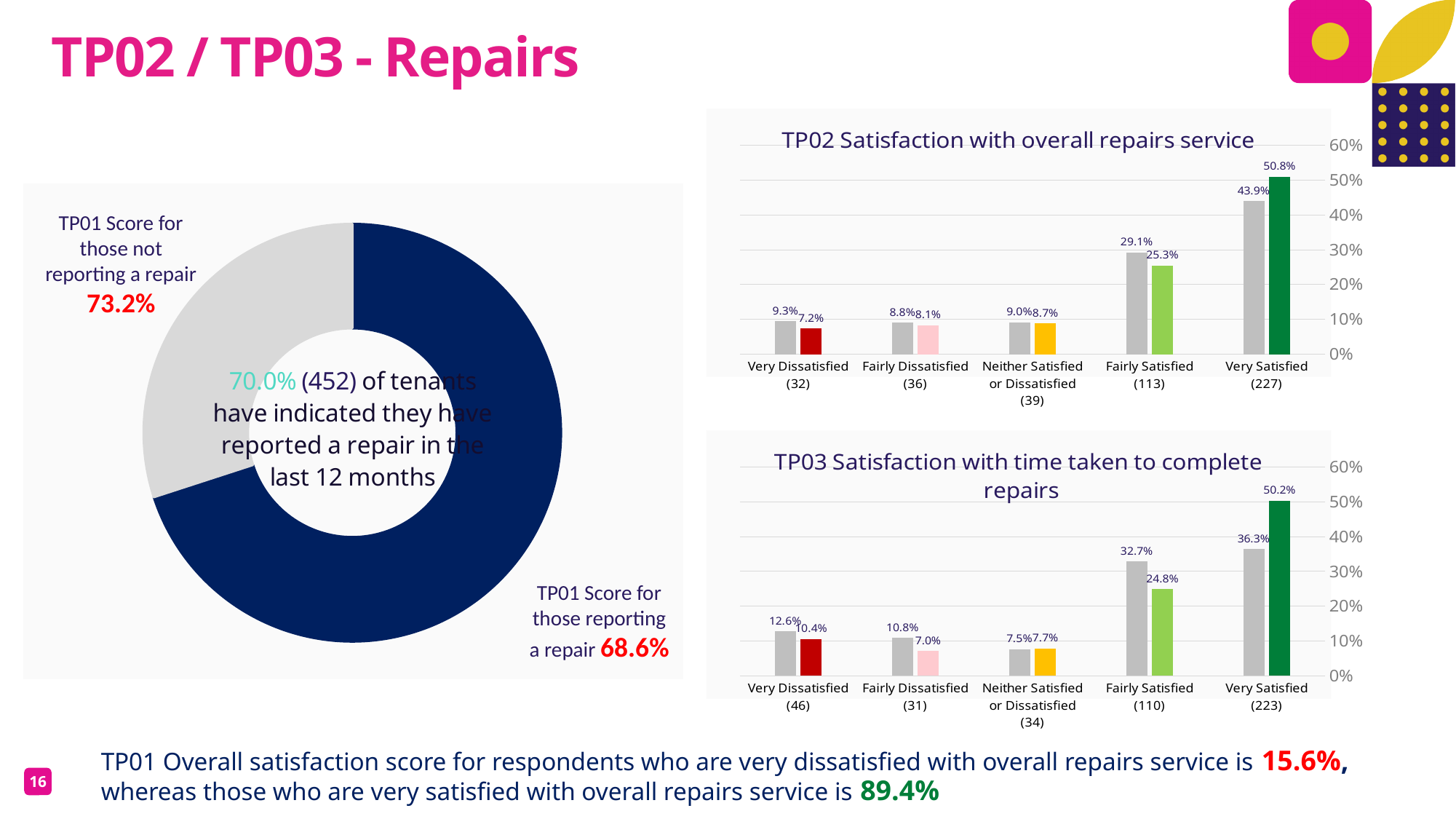
In the TP02 Satisfaction with overall repairs service chart, what is the difference between the green bar (50.8%) and the grey bar (43.9%) for Very Satisfied? 6.9% In the TP03 Satisfaction with time taken to complete repairs chart, which category has the lowest grey bar? Neither Satisfied or Dissatisfied In the TP02 Satisfaction with overall repairs service chart, what value is labelled on the grey bar for Fairly Satisfied? 29.1% In the TP03 Satisfaction with time taken to complete repairs chart, which is larger for Fairly Satisfied: the grey bar or the light green bar? the grey bar How many categories are shown on the x axis of the TP02 Satisfaction with overall repairs service chart? 5 In the TP03 Satisfaction with time taken to complete repairs chart, what value is labelled on the red bar for Very Dissatisfied? 10.4% In the TP01 donut chart on the left, what percentage of tenants have indicated they have reported a repair in the last 12 months? 70.0% In the TP03 Satisfaction with time taken to complete repairs chart, what value is labelled on the green bar for Very Satisfied? 50.2% In the TP02 Satisfaction with overall repairs service chart, what value is labelled on the green bar for Very Satisfied? 50.8% What kind of chart is the TP01 chart on the left of the slide? donut chart In the TP03 Satisfaction with time taken to complete repairs chart, is the green bar for Very Satisfied greater or less than 40%? greater In the TP02 Satisfaction with overall repairs service chart, which category has the highest coloured bar? Very Satisfied